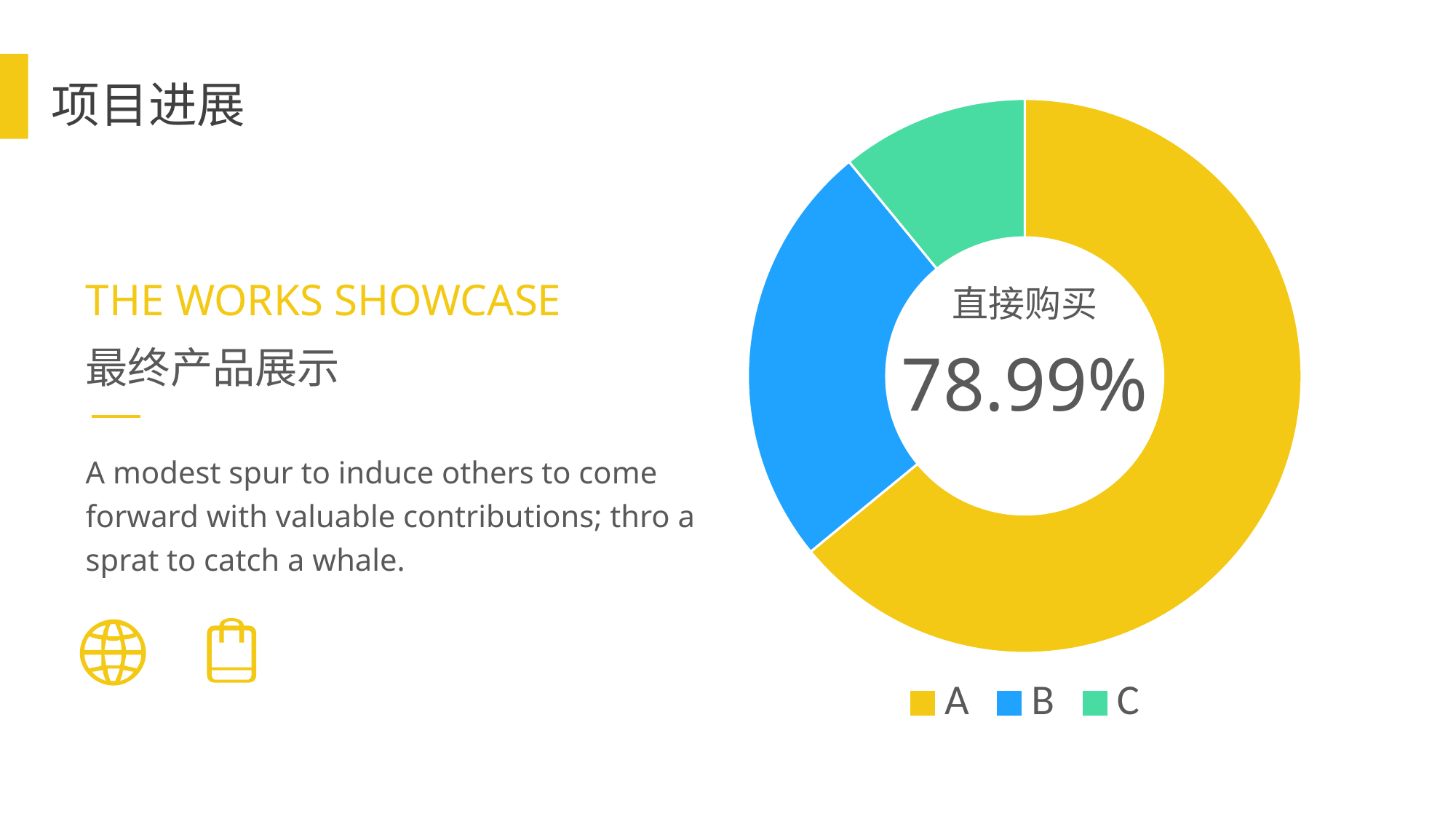
How many categories does the chart show? 3 What kind of chart is shown on the slide? doughnut (pie) chart Which slice is larger, A or B? A What percentage is printed in the centre of the doughnut chart? 78.99% Which category has the largest slice? A How many entries does the legend list? 3 Which slice is larger, B or C? B Does slice A take up more or less than half of the chart? more Which category has the smallest slice? C What colour is the slice for category A? yellow